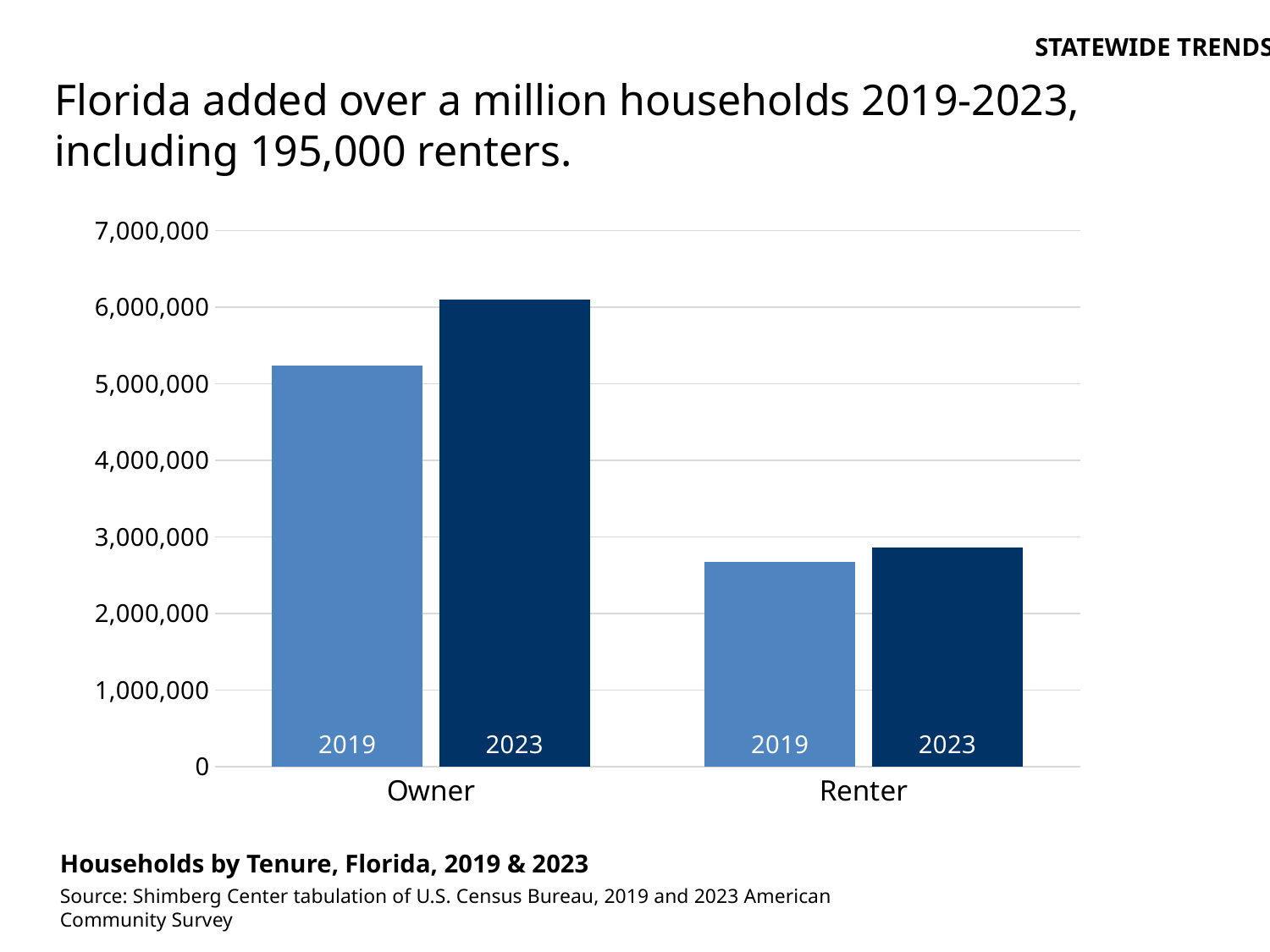
For Renter households, which year has the larger value, 2019 or 2023? 2023 What is the title of the chart? Households by Tenure, Florida, 2019 & 2023 For Owner households, which year has the larger value, 2019 or 2023? 2023 What kind of chart is shown on the slide? bar chart Is the value for Owner in 2019 greater or less than 5,000,000? greater Which bar is the tallest in the chart? Owner 2023 Is the value for Renter in 2019 greater or less than 3,000,000? less Which bar is the shortest in the chart? Renter 2019 How many tenure categories are shown on the x axis? 2 Did the number of households rise or fall from 2019 to 2023 for both Owner and Renter? rise Is the value for Renter in 2023 greater or less than 3,000,000? less